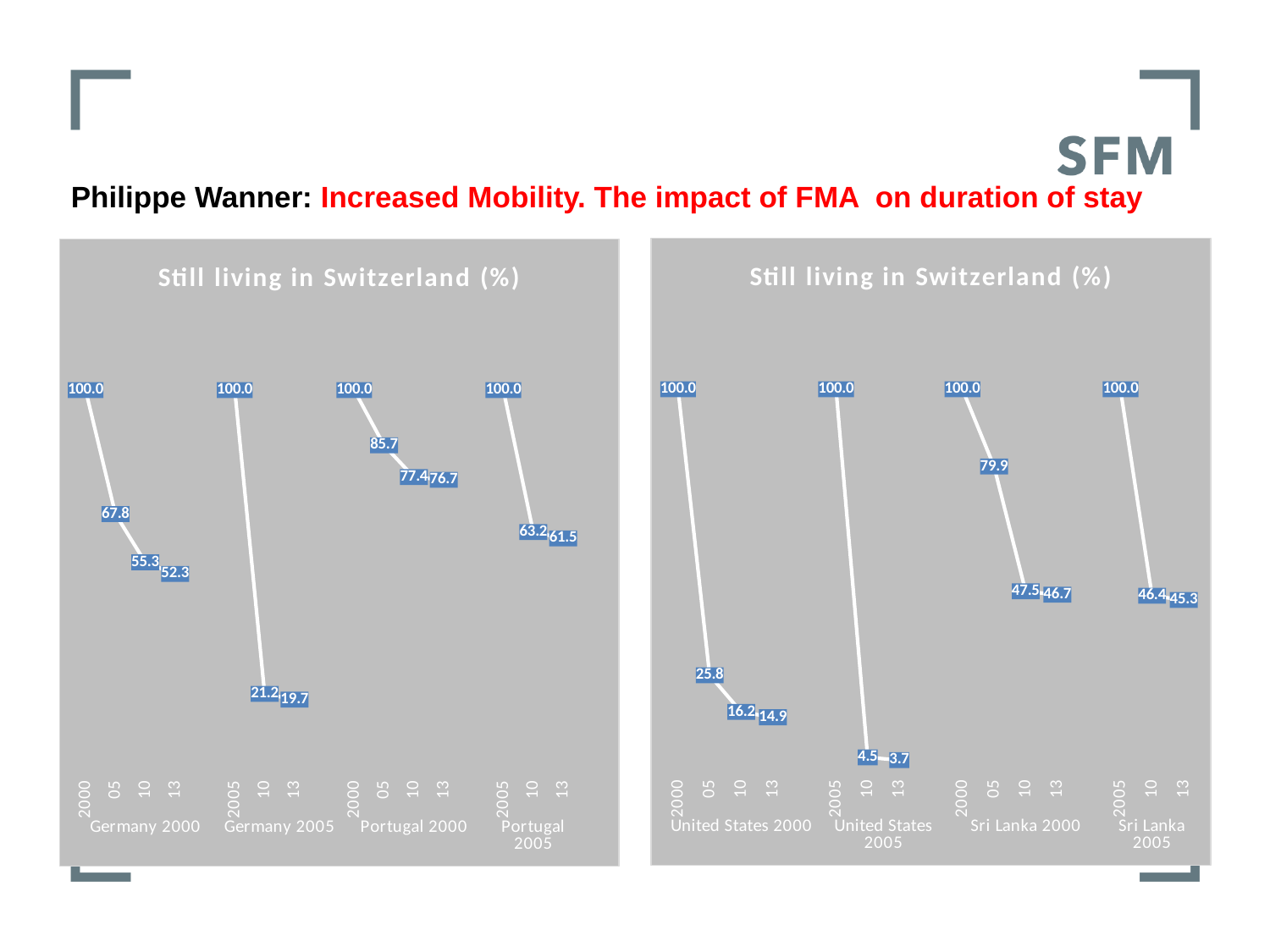
In the left chart, what is the value for Germany 2005 in 2010? 21.2 In the left chart, what is the value for Germany 2000 in 2013? 52.3 In the left chart, which group has the lowest value in 2013? Germany 2005 In the left chart, do the values for Portugal 2000 rise or fall from 2000 to 2013? fall In the left chart, what is the value for Portugal 2000 in 2005? 85.7 In the right chart, what is the value for United States 2005 in 2013? 3.7 In the right chart, which is larger in 2013: United States 2000 or Sri Lanka 2000? Sri Lanka 2000 What is the title of the right chart? Still living in Switzerland (%) In the right chart, what is the value for Sri Lanka 2000 in 2010? 47.5 In the left chart, what is the value for Portugal 2005 in 2013? 61.5 In the right chart, what is the value for United States 2000 in 2005? 25.8 In the right chart, what is the difference between the Sri Lanka 2005 values for 2010 and 2013? 1.1